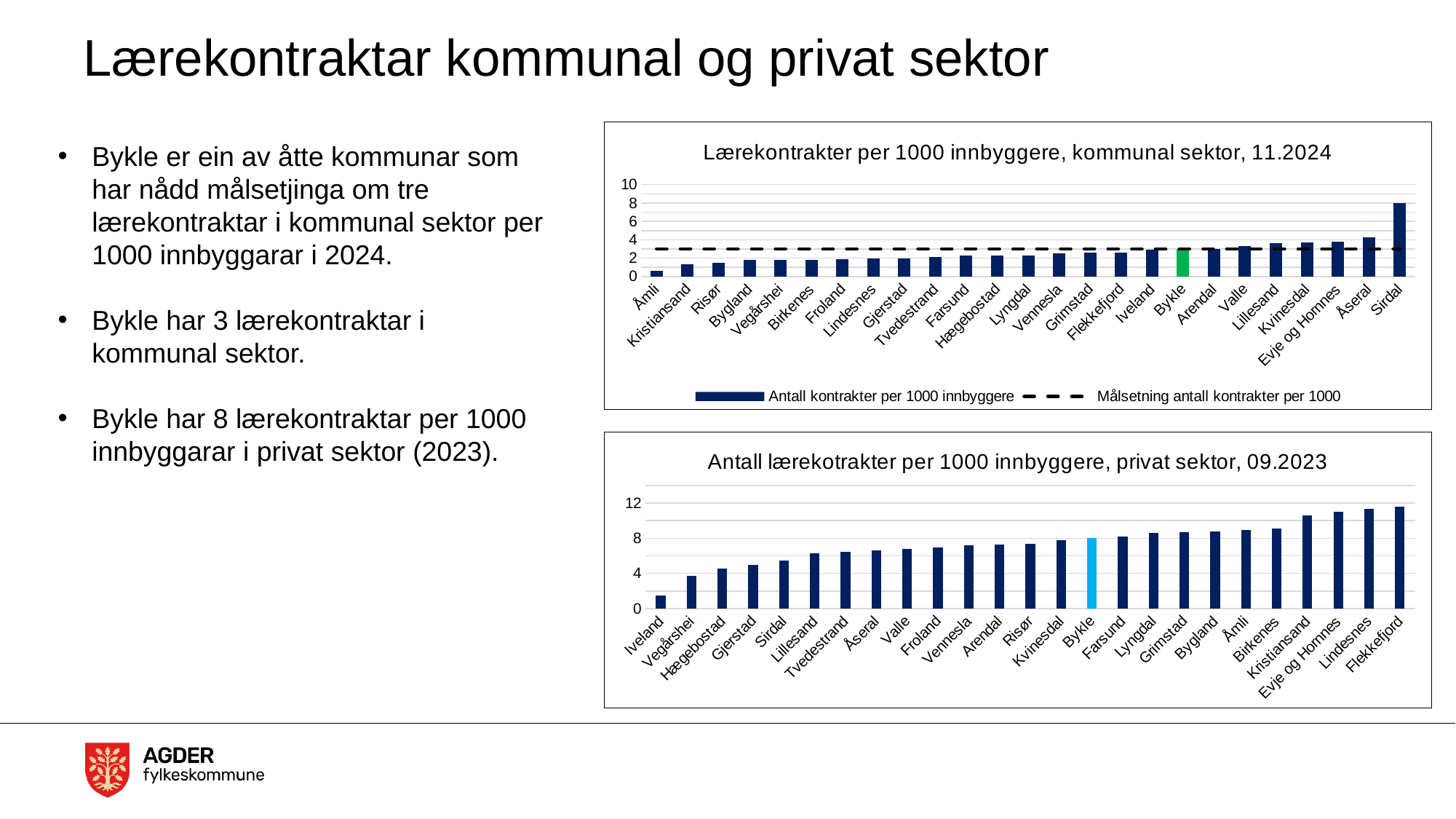
In the bottom chart (privat sektor, 09.2023), is the value for Iveland greater or less than 4? less In the bottom chart (privat sektor, 09.2023), which municipality has the lowest value? Iveland In the bottom chart (privat sektor, 09.2023), which municipality has the highest value? Flekkefjord In the top chart (kommunal sektor, 11.2024), which is larger, the value for Sirdal or the value for Åseral? Sirdal In the bottom chart (privat sektor, 09.2023), what is the value for Bykle? 8 In the bottom chart (privat sektor, 09.2023), do the values rise or fall from left to right along the x axis? Rise How many series does the legend of the top chart (kommunal sektor, 11.2024) list? 2 In the top chart (kommunal sektor, 11.2024), is the value for Sirdal greater or less than 6? greater In the top chart (kommunal sektor, 11.2024), which municipality has the highest number of contracts per 1000 inhabitants? Sirdal In the top chart (kommunal sektor, 11.2024), which municipality has the lowest value? Åmli What kind of chart is the bottom chart (privat sektor, 09.2023)? Bar chart How many municipalities are shown in the top chart (kommunal sektor, 11.2024)? 25